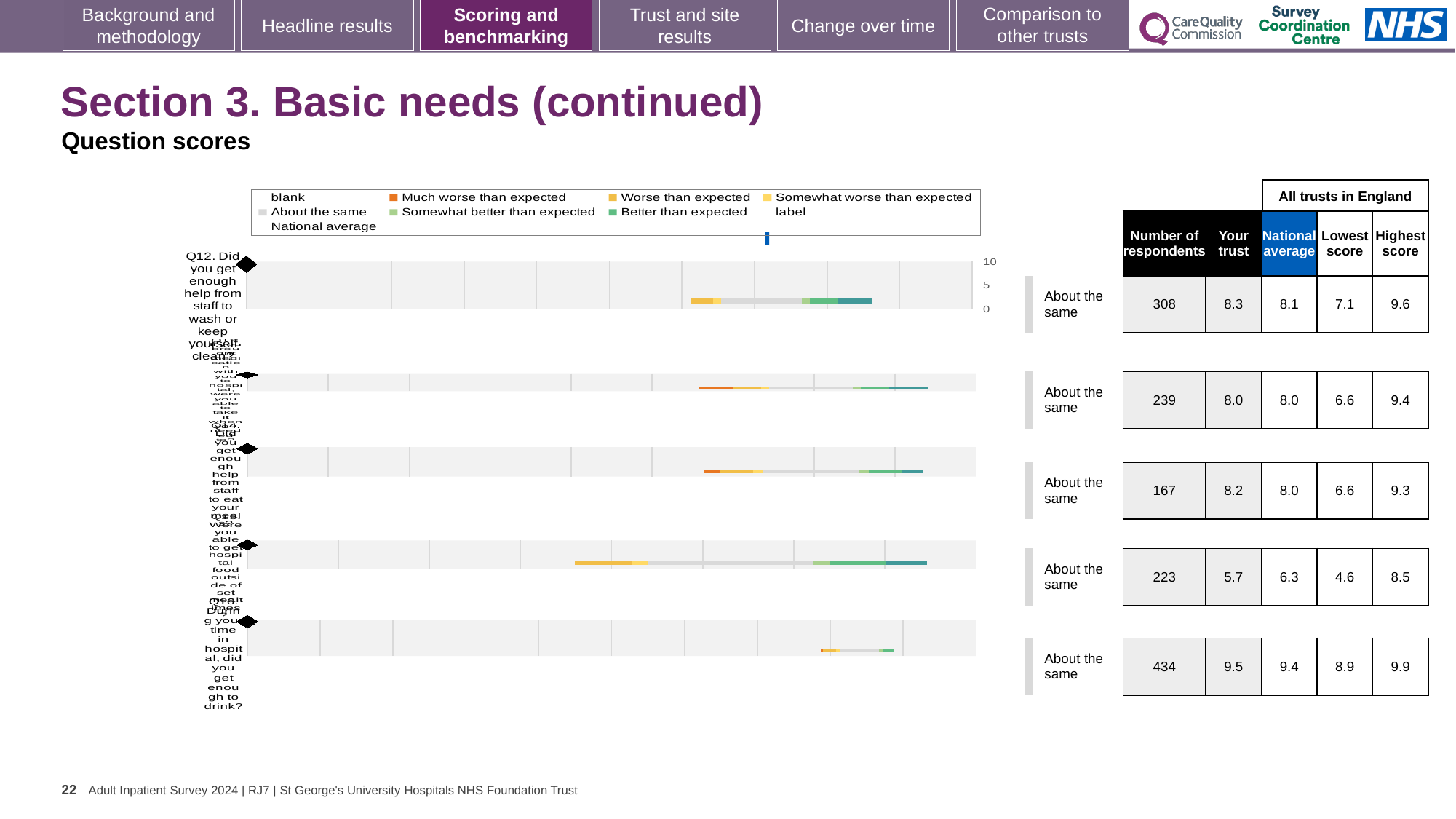
In the table beside the chart, how many respondents are listed for Q12? 308 Which row in the table has the highest 'Your trust' score? the bottom row (434 respondents), 9.5 In the table beside the chart, what is the national average for Q12? 8.1 Which row in the table has the lowest 'Your trust' score? the fourth row (223 respondents), 5.7 For Q12, what is the difference between the highest score and the lowest score across all trusts in England? 2.5 What benchmark category is shown for every question row on this slide? About the same In the table beside the chart, what is the 'Your trust' score for Q12 (Did you get enough help from staff to wash or keep yourself clean?)? 8.3 What kind of chart is used to show the question scores on this slide? bar chart How many question rows (bars) are plotted in the chart? 5 In the table beside the chart, what is the lowest score for the fourth row (223 respondents)? 4.6 For Q12, which is larger: the 'Your trust' score or the national average? Your trust In the chart legend, what colour represents 'Much worse than expected'? orange